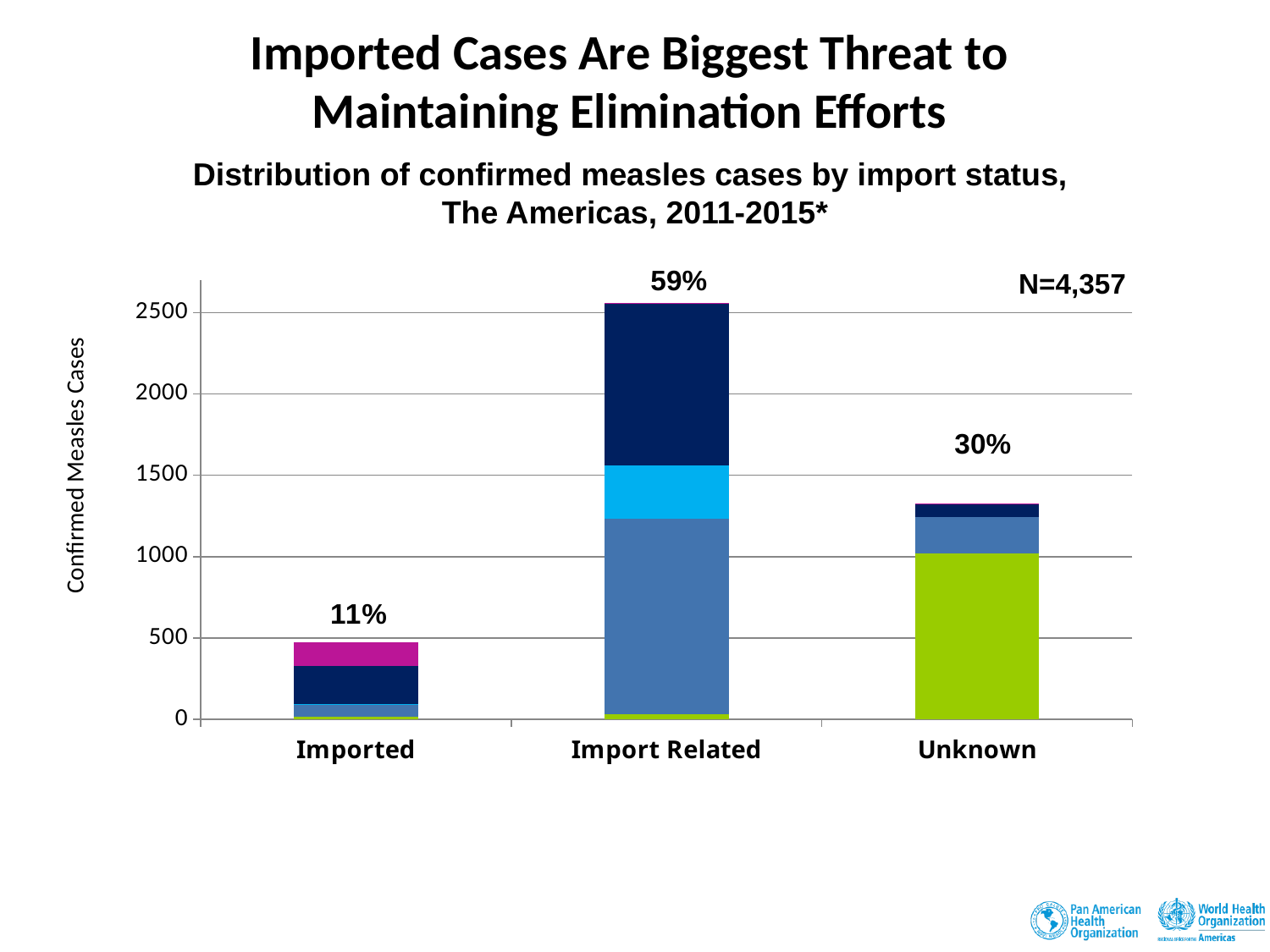
Which bar is taller, Unknown or Imported? Unknown What percentage label is shown above the Import Related bar? 59% What kind of chart is shown on the slide? Stacked bar chart How many import status categories are shown on the x axis? 3 What percentage label is shown above the Imported bar? 11% What total N is stated on the chart? N=4,357 What percentage label is shown above the Unknown bar? 30% Which import status category has the lowest number of confirmed measles cases? Imported What is the difference in percentage points between the Import Related share and the Imported share? 48 percentage points Which import status category has the highest number of confirmed measles cases? Import Related Is the total value for the Import Related bar greater or less than 2500? greater